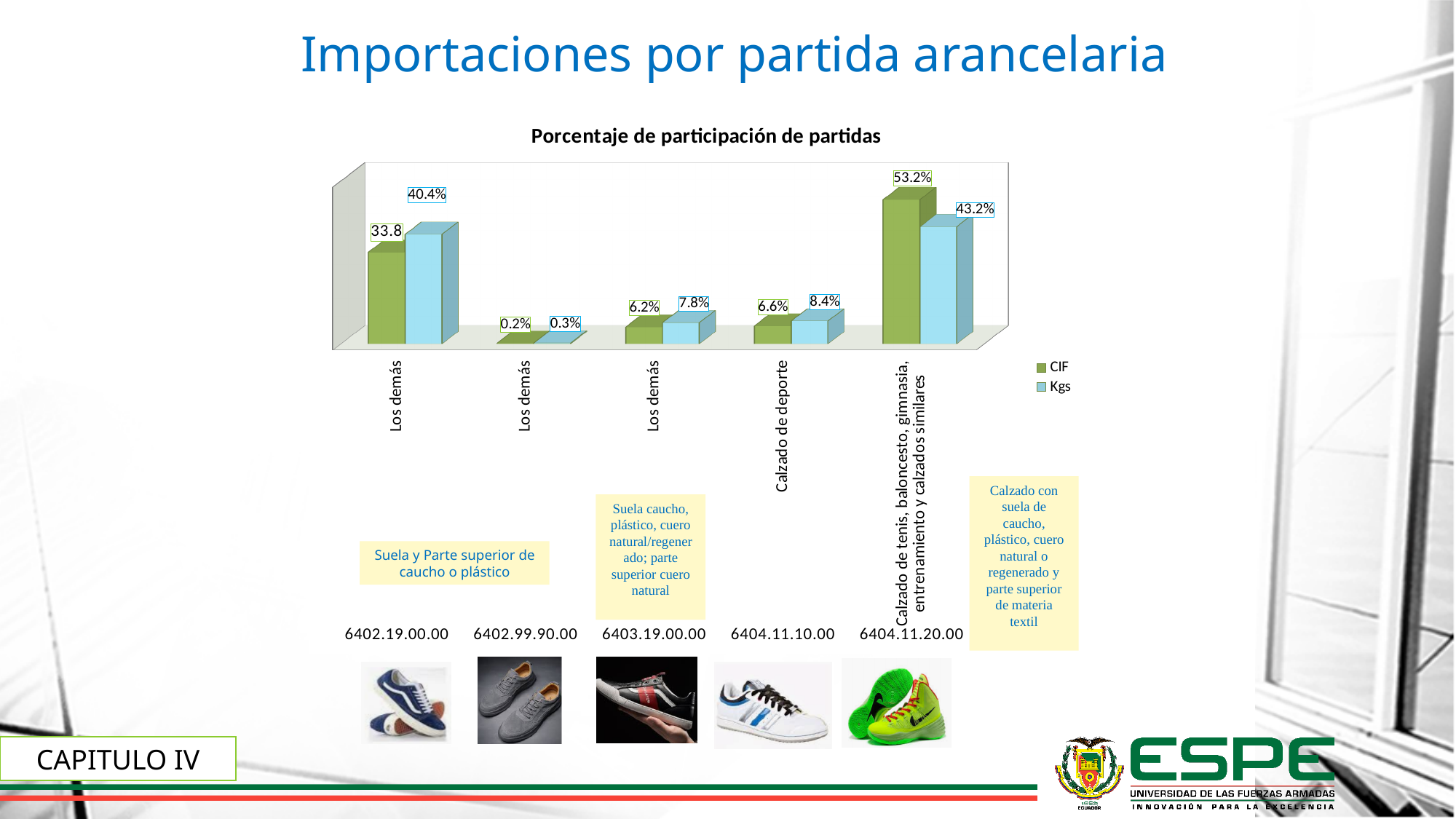
What is the Kgs value for Calzado de deporte? 8.4% How many categories are shown on the x axis of the chart? 5 How many series does the legend list? 2 What is the difference between the CIF and Kgs values for Calzado de tenis, baloncesto, gimnasia, entrenamiento y calzados similares? 10 percentage points What is the CIF value for the category with tariff code 6403.19.00.00? 6.2% For Calzado de deporte, which is larger, the CIF value or the Kgs value? Kgs What is the CIF value for Calzado de tenis, baloncesto, gimnasia, entrenamiento y calzados similares? 53.2% Which category has the highest CIF value? Calzado de tenis, baloncesto, gimnasia, entrenamiento y calzados similares What kind of chart is shown on the slide? Bar chart What is the title of the chart? Porcentaje de participación de partidas Which tariff code has the lowest Kgs value? 6402.99.90.00 What is the Kgs value for the category with tariff code 6402.19.00.00? 40.4%